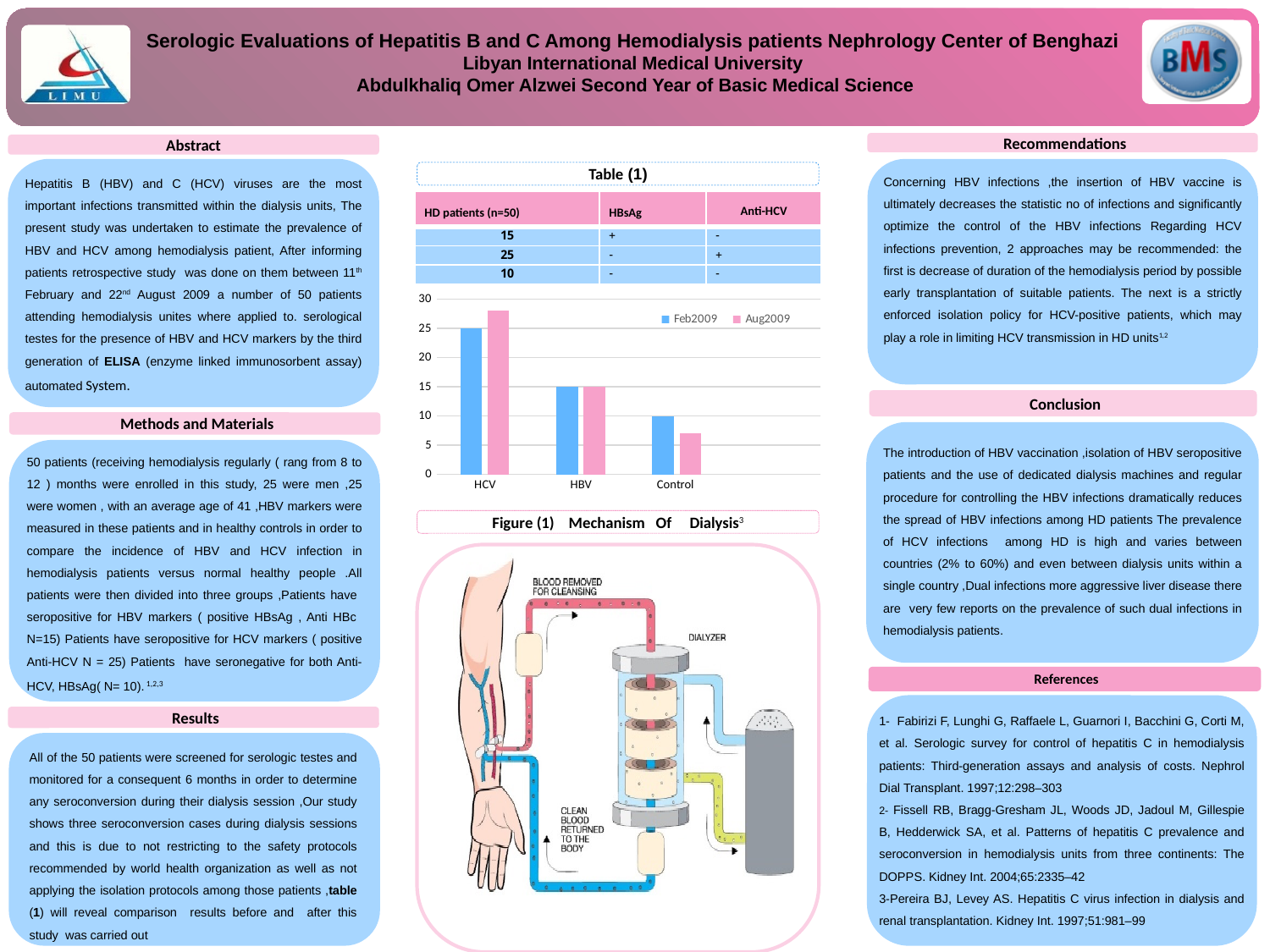
What is the difference between the Feb2009 values for HCV and Control? 15 Is the Aug2009 value for Control greater or less than 10? less Which category has the highest Feb2009 value? HCV Is the Aug2009 value for HCV greater or less than 25? greater What kind of chart is shown on the slide? bar chart How many categories are shown on the x axis of the chart? 3 What is the Feb2009 value for HCV? 25 What is the Feb2009 value for Control? 10 How many series does the chart's legend list? 2 Which category has the lowest Aug2009 value? Control What is the Aug2009 value for HBV? 15 What is the Feb2009 value for HBV? 15